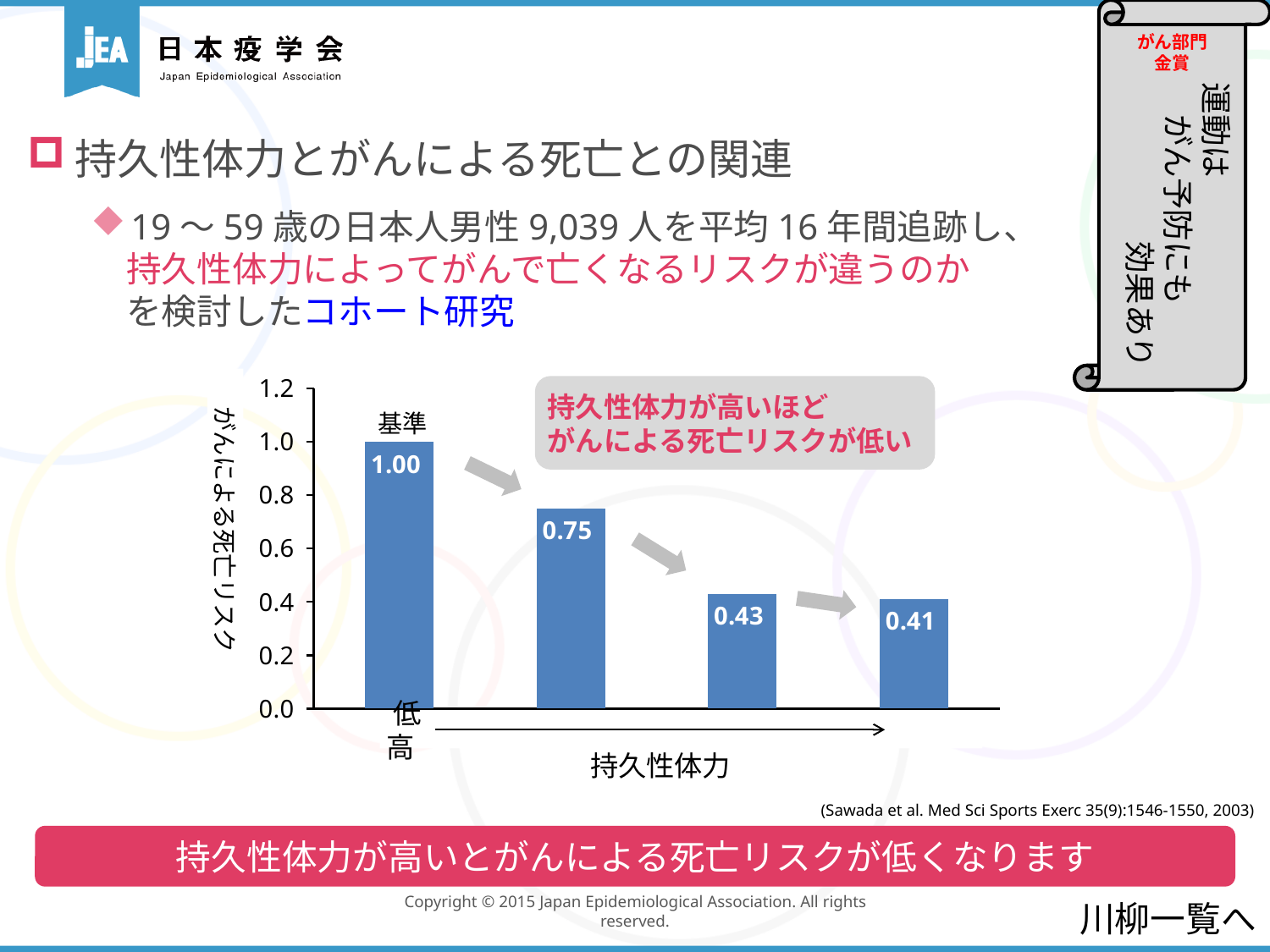
Do the bar values rise or fall as 持久性体力 increases from 低 to 高 along the x axis? Fall What is the value shown on the rightmost bar? 0.41 What is the value shown on the second bar from the left? 0.75 What is the difference between the leftmost bar (1.00) and the second bar (0.75)? 0.25 What kind of chart is shown on the slide? Bar chart What is the difference between the leftmost bar (1.00) and the rightmost bar (0.41)? 0.59 What is the value shown on the leftmost bar (labeled 基準)? 1.00 Which bar has the lowest value? The rightmost bar (0.41) Which bar has the highest value? The leftmost bar (基準, 1.00) Which is larger, the second bar from the left or the third bar from the left? The second bar from the left (0.75) What is the value shown on the third bar from the left? 0.43 How many bars are plotted in the chart? 4